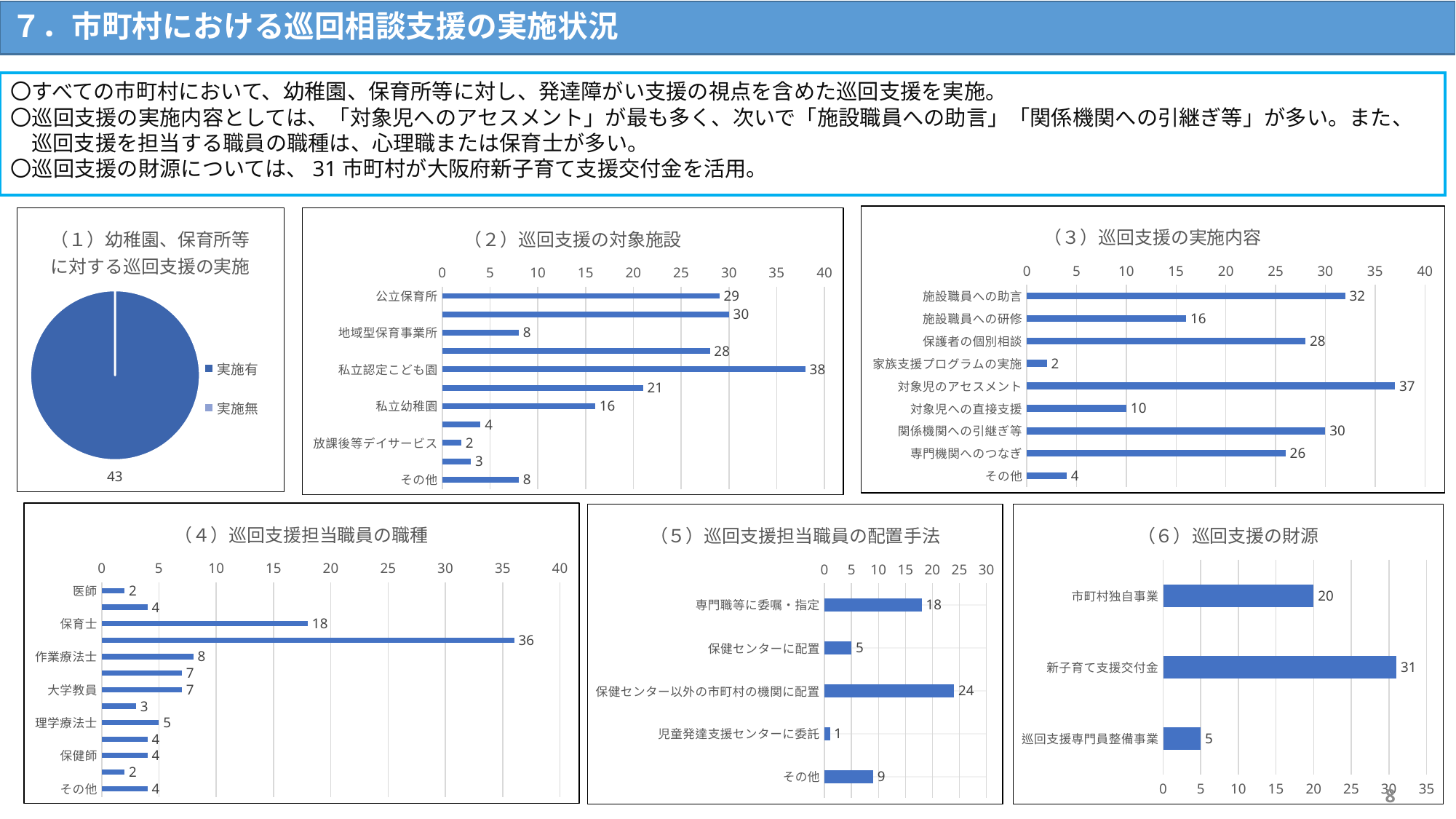
What type of chart is chart (1) 幼稚園、保育所等に対する巡回支援の実施? pie chart In chart (5) 巡回支援担当職員の配置手法, what is the value for 保健センター以外の市町村の機関に配置? 24 In chart (3) 巡回支援の実施内容, what is the value for 対象児のアセスメント? 37 In chart (6) 巡回支援の財源, what is the value for 新子育て支援交付金? 31 In chart (5) 巡回支援担当職員の配置手法, which is larger: 専門職等に委嘱・指定 or その他? 専門職等に委嘱・指定 In chart (2) 巡回支援の対象施設, what is the highest value shown on any bar? 38 In chart (3) 巡回支援の実施内容, how many categories are plotted? 9 In chart (3) 巡回支援の実施内容, what is the difference between 施設職員への助言 and 施設職員への研修? 16 In chart (6) 巡回支援の財源, how many categories are plotted? 3 In chart (5) 巡回支援担当職員の配置手法, which category has the lowest value? 児童発達支援センターに委託 In chart (6) 巡回支援の財源, what is the difference between 市町村独自事業 and 巡回支援専門員整備事業? 15 In chart (3) 巡回支援の実施内容, which category has the lowest value? 家族支援プログラムの実施